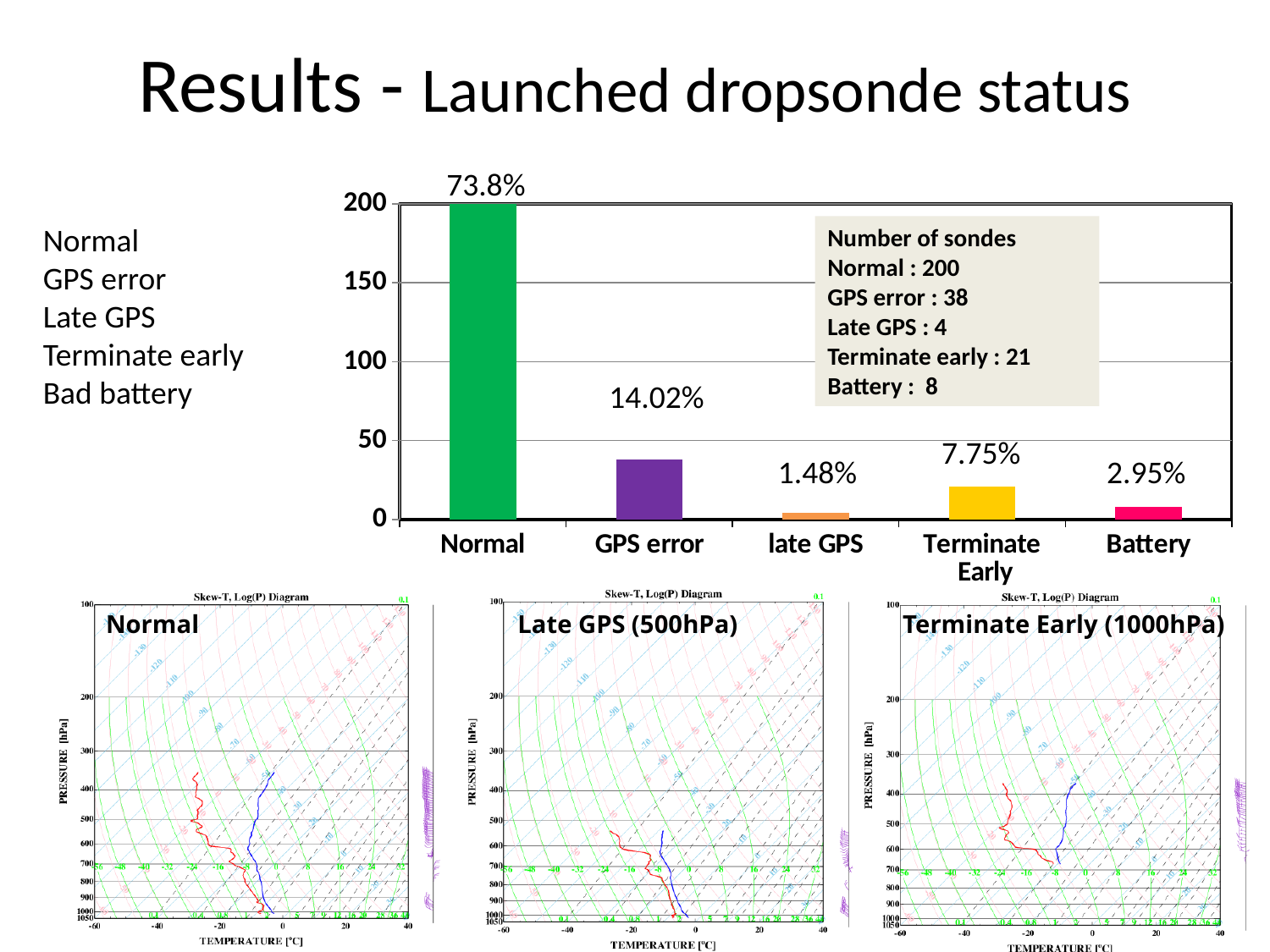
In the bar chart at the top of the slide, how many categories are shown on the x axis? 5 In the bar chart at the top of the slide, which category has the tallest bar? Normal In the bar chart at the top of the slide, is the value for GPS error greater or less than 50? less In the bar chart at the top of the slide, what percentage is labelled on the Terminate Early bar? 7.75% In the bar chart at the top of the slide, what percentage is labelled on the Battery bar? 2.95% In the bar chart at the top of the slide, which category has the shortest bar? late GPS What type of chart is shown at the top of the slide? bar chart In the bar chart at the top of the slide, what percentage is labelled on the GPS error bar? 14.02% In the bar chart at the top of the slide, what is the highest value shown on the y axis? 200 In the bar chart at the top of the slide, which bar is taller: GPS error or Terminate Early? GPS error In the bar chart at the top of the slide, what percentage is labelled on the late GPS bar? 1.48% In the bar chart at the top of the slide, what percentage is labelled on the Normal bar? 73.8%